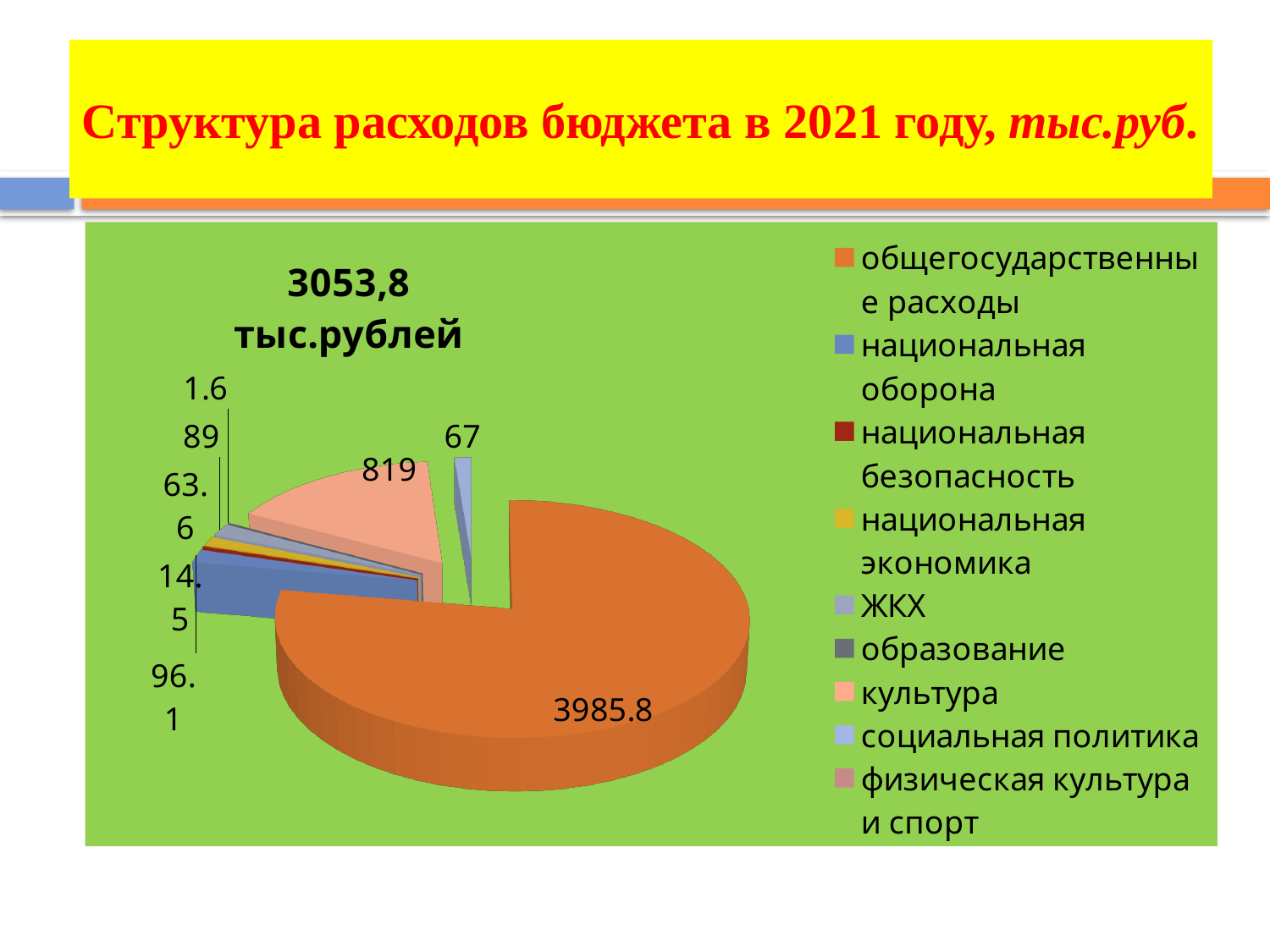
What is the value shown for социальная политика? 67 What is the value shown for общегосударственные расходы? 3985.8 What is the smallest data label printed on the pie chart? 1.6 What kind of chart is shown on the slide? pie chart What is the value shown for культура? 819 What is the title printed above the pie chart? 3053,8 тыс.рублей How many categories does the legend of the pie chart list? 9 Which is larger, the value for культура or the value for социальная политика? культура What colour is the slice for общегосударственные расходы? orange Which category has the largest slice of the pie? общегосударственные расходы What is the difference between the value for общегосударственные расходы and the value for культура? 3166.8